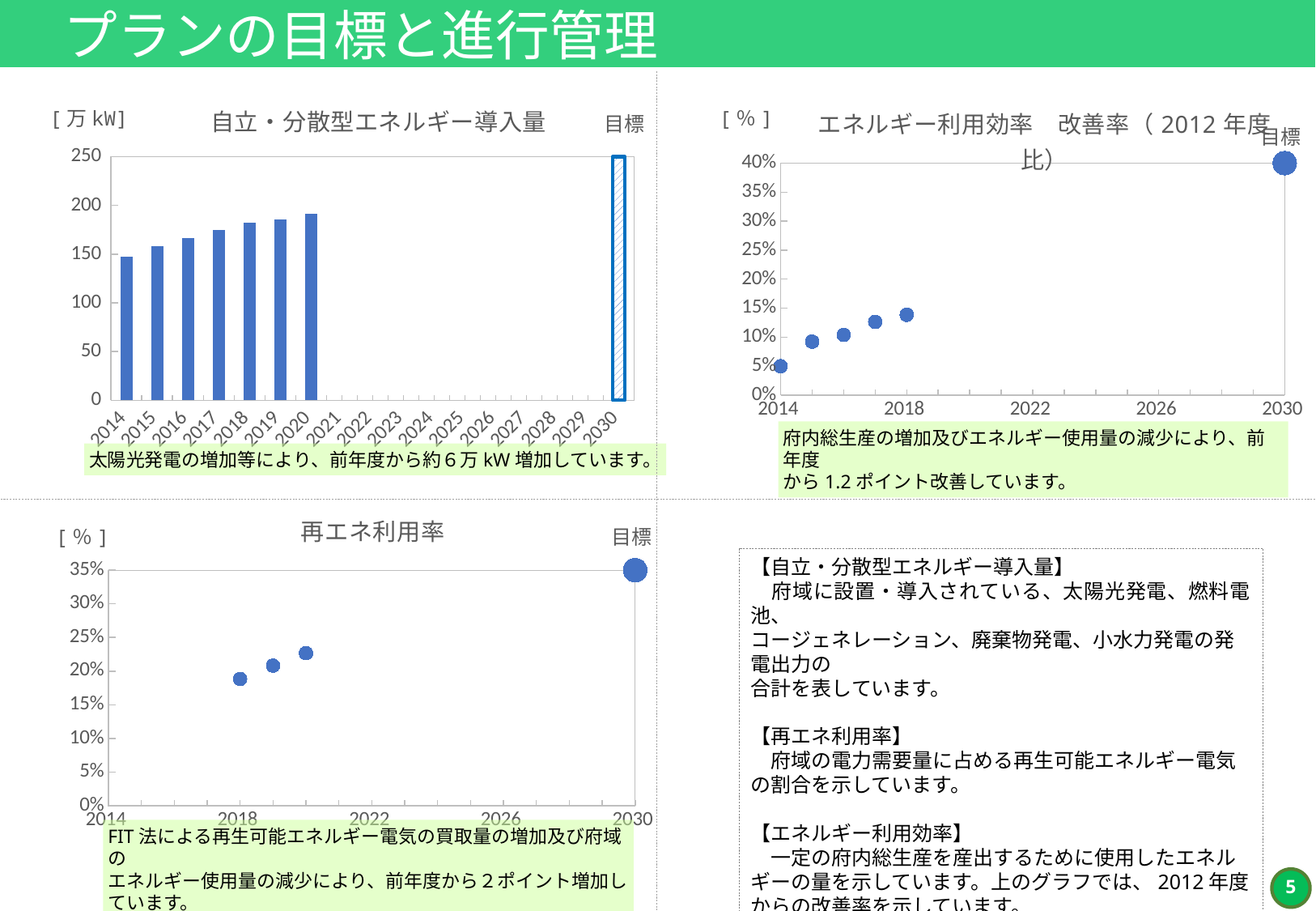
What kind of chart is the 自立・分散型エネルギー導入量 chart? bar chart In the エネルギー利用効率 改善率 chart, is the value for 2014 greater or less than 10%? less In the 再エネ利用率 chart, is the value for 2020 greater or less than 25%? less In the 再エネ利用率 chart, what is the 目標 (target) value plotted at 2030? 35% In the エネルギー利用効率 改善率 chart, is the value for 2018 greater or less than 10%? greater What unit is shown on the y axis of the 自立・分散型エネルギー導入量 chart? 万kW In the 自立・分散型エネルギー導入量 chart, which year among 2014 to 2020 has the lowest value? 2014 In the エネルギー利用効率 改善率 chart, what is the 目標 (target) value plotted at 2030? 40% In the 自立・分散型エネルギー導入量 chart, do the values rise or fall from 2014 to 2020? rise In the 再エネ利用率 chart, do the values rise or fall from 2018 to 2020? rise